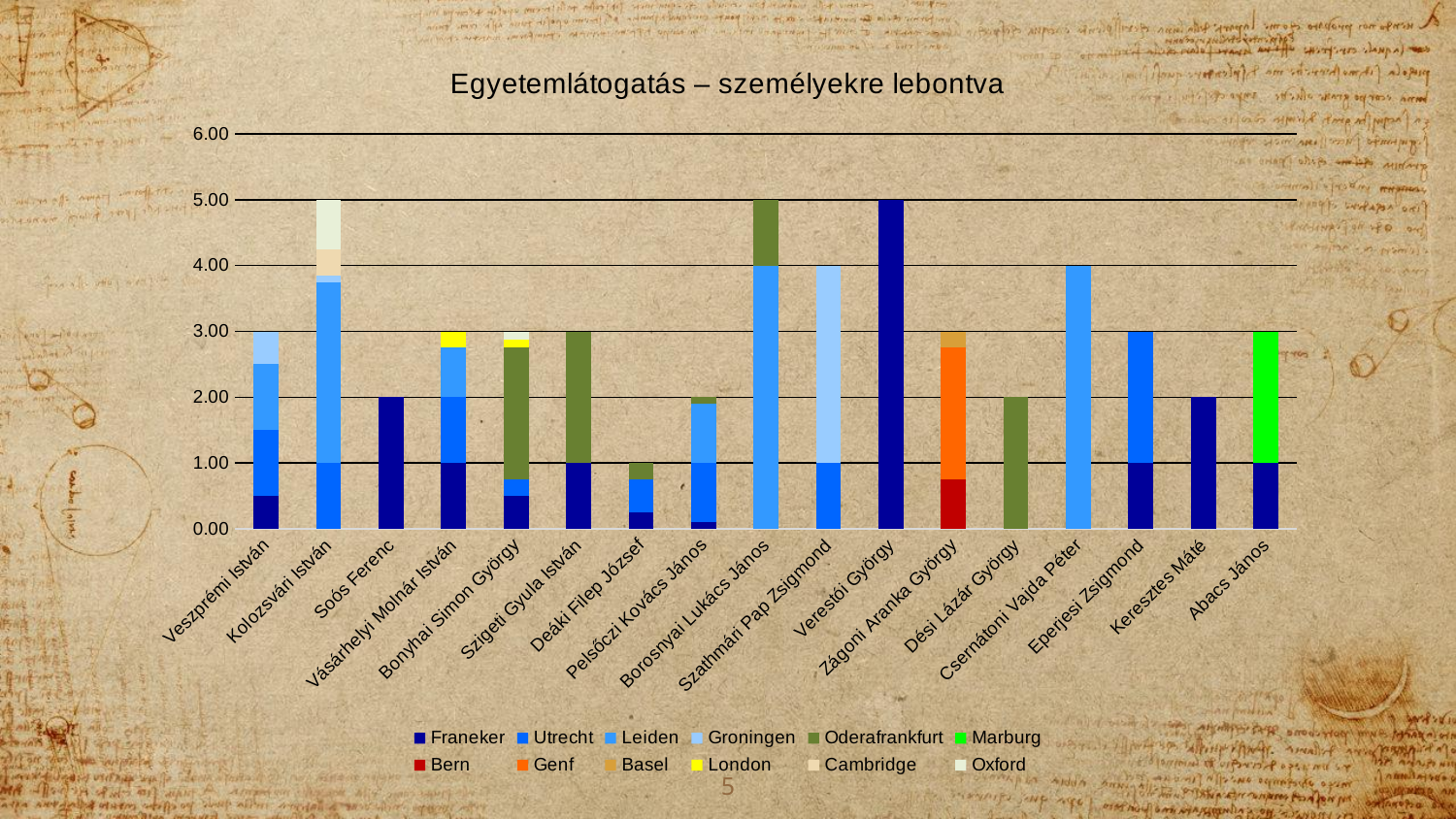
What is the difference between the total bars of Verestói György and Soós Ferenc? 3.00 What kind of chart is shown on the slide? Stacked bar chart Is the total value for Dési Lázár György greater or less than 3.00? less How many persons (categories) are shown on the x axis? 17 What is the title of the chart? Egyetemlátogatás – személyekre lebontva What is the total value of the bar for Soós Ferenc? 2.00 Which person has the lowest total bar? Deáki Filep József Which bar is taller, Verestói György or Keresztes Máté? Verestói György What is the total value of the bar for Verestói György? 5.00 Which series does the bright green segment in the bar for Abacs János represent? Marburg Is the total value for Csernátoni Vajda Péter greater or less than 3.00? greater How many series does the legend list? 12